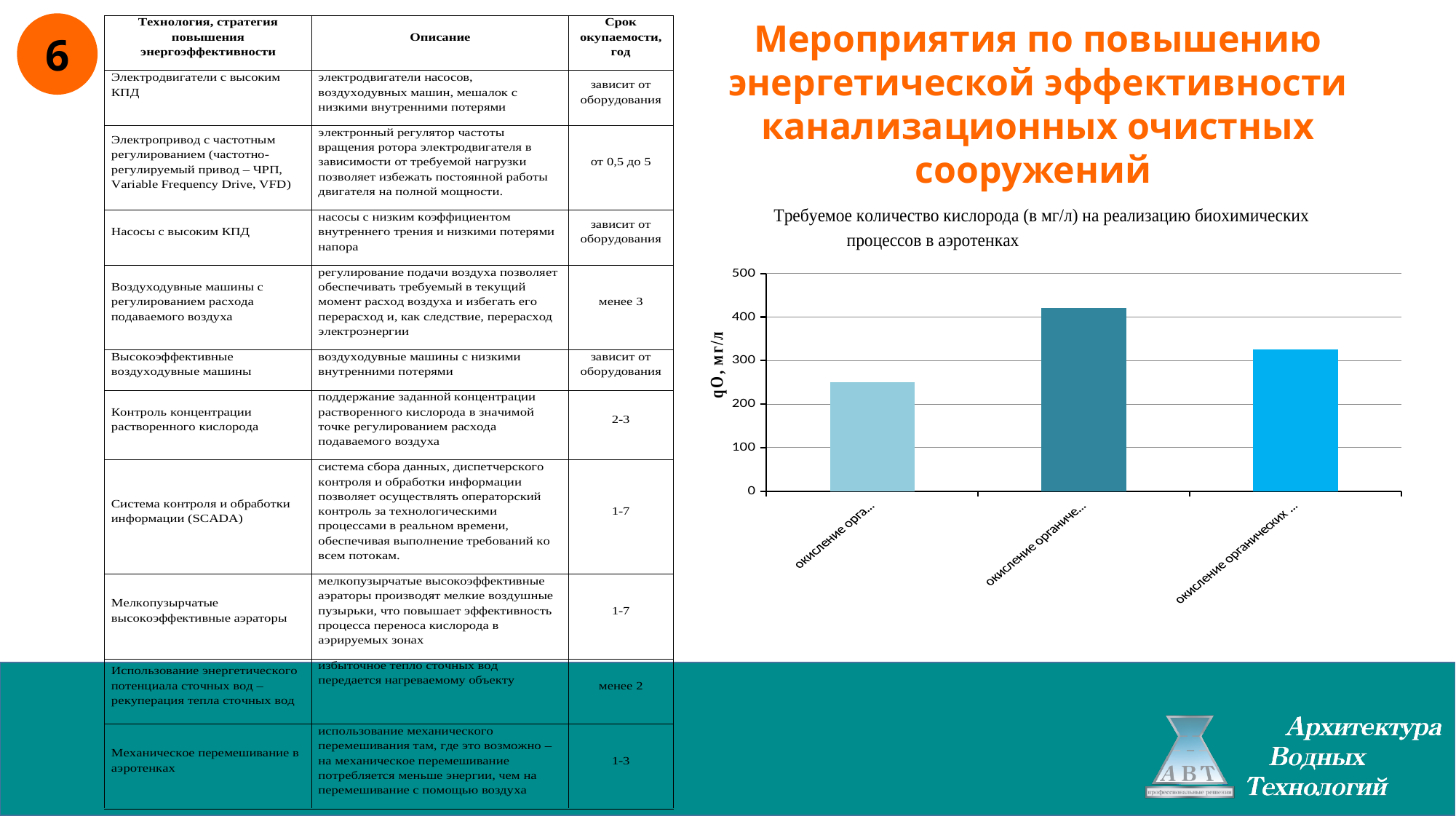
Which bar is the shortest in the chart: the left, middle or right one? left Is the value of the left bar greater or less than 300? less What is the label of the vertical axis of the chart? qO, мг/л Is the value of the middle bar greater or less than 400? greater What kind of chart is shown on the slide? bar chart How many bars does the chart show? 3 Which is larger, the middle bar or the right bar? middle bar Is the value of the left bar greater or less than 200? greater Which bar is the tallest in the chart: the left, middle or right one? middle What is the highest value shown on the vertical axis of the chart? 500